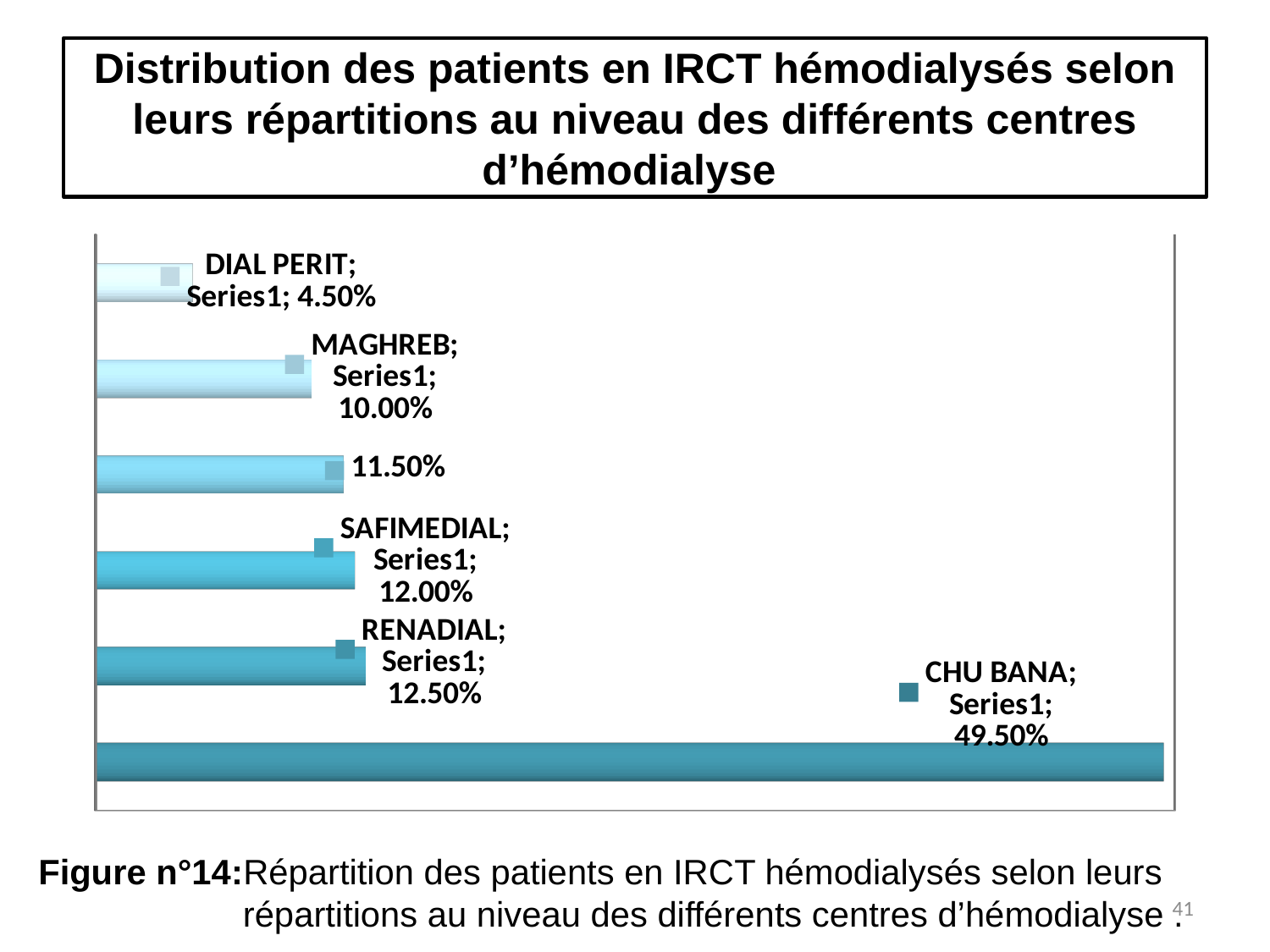
Which is larger, the value for MAGHREB or the value for SAFIMEDIAL? SAFIMEDIAL What is the difference between the values for CHU BANA and RENADIAL? 37.00% What is the value for RENADIAL? 12.50% What is the value for SAFIMEDIAL? 12.00% What is the value for DIAL PERIT? 4.50% What is the difference between the values for MAGHREB and DIAL PERIT? 5.50% How many bars are plotted in the chart? 6 What is the value for MAGHREB? 10.00% Which centre has the highest value? CHU BANA What is the value for CHU BANA? 49.50% Which centre has the lowest value? DIAL PERIT What kind of chart is shown on the slide? bar chart